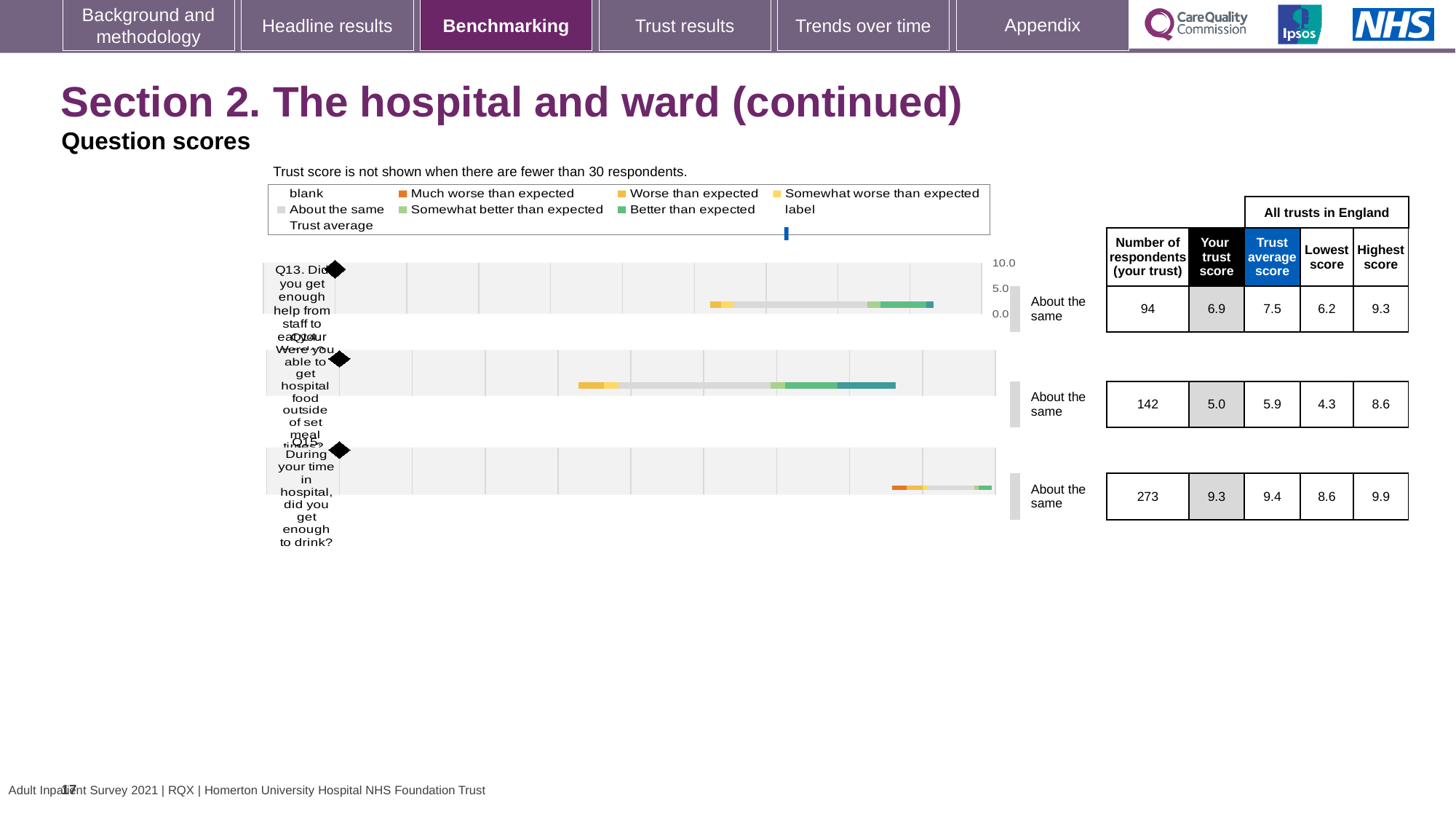
What is the difference between the trust average score and the trust score for Q14? 0.9 What benchmark category is shown for all three questions? About the same Which has the larger trust score, Q13 or Q14? Q13 How many questions are plotted in the chart? 3 Which question has the highest trust score? Q15 Which question has the lowest trust score? Q14 Which legend entry is shown in orange? Much worse than expected What is the trust average score for Q15 (did you get enough to drink?)? 9.4 What is the trust score for Q13 (Did you get enough help from staff to eat your meals?)? 6.9 What kind of chart is used to show the question scores on this slide? Bar chart How many respondents answered Q14 (Were you able to get hospital food outside of set meal times?)? 142 What is the highest score across all trusts in England for Q13? 9.3